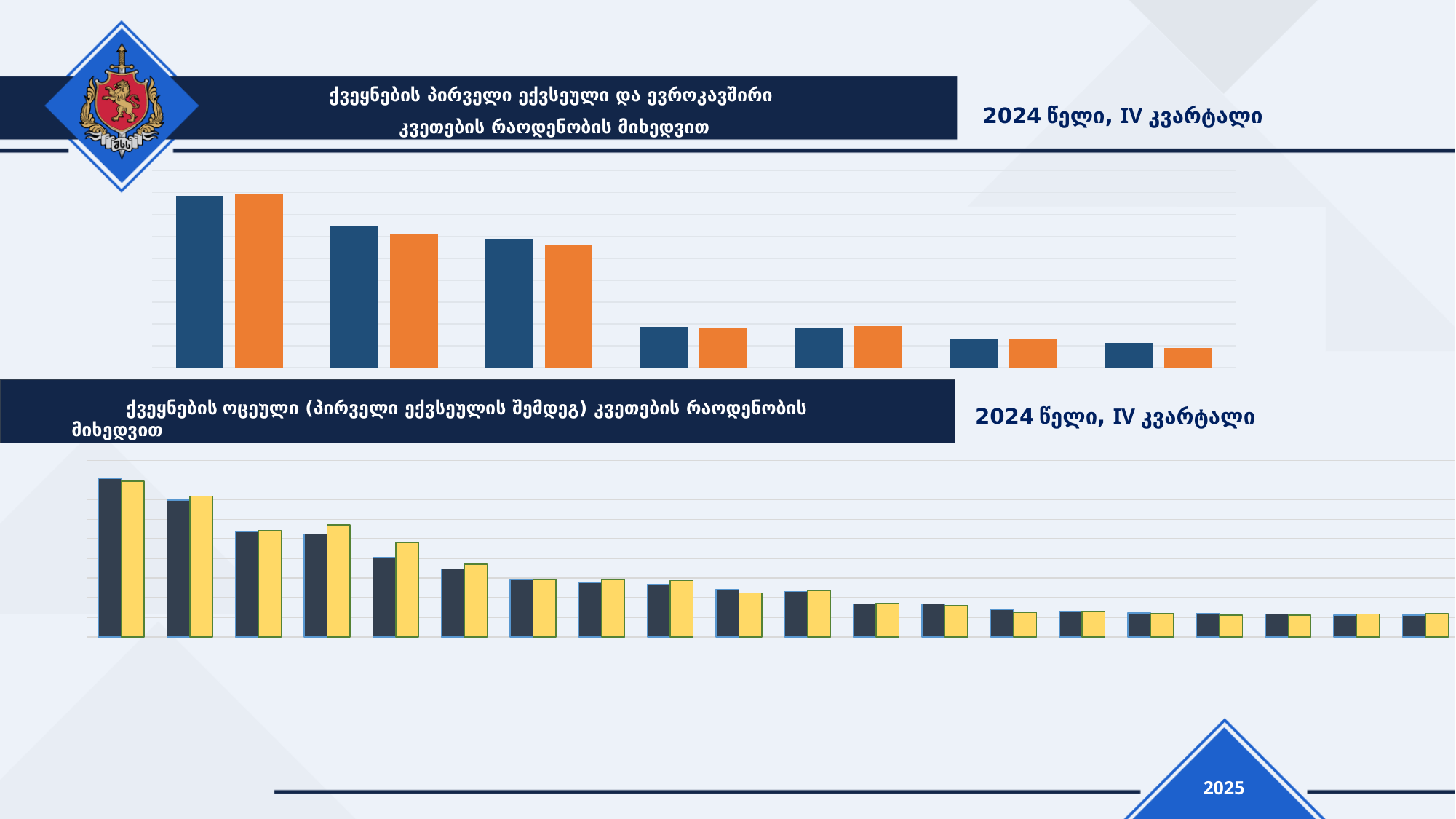
In the top chart, in the second group from the left, which bar is taller, the blue one or the orange one? the blue one In the bottom chart, do the bar heights rise or fall from left to right? fall In the top chart, which category group has the tallest bars? the leftmost (first) group In the bottom chart, how many data series (bar colours) are plotted? 2 In the bottom chart, in the fifth group from the left, which bar is taller, the dark one or the yellow one? the yellow one In the top chart, how many data series (bar colours) are plotted? 2 In the bottom chart, how many category groups of bars are plotted? 20 In the top chart, do the bar heights rise or fall from left to right? fall What kind of chart is the bottom chart on the slide? bar chart In the top chart, how many category groups of bars are plotted? 7 What kind of chart is the top chart on the slide? bar chart